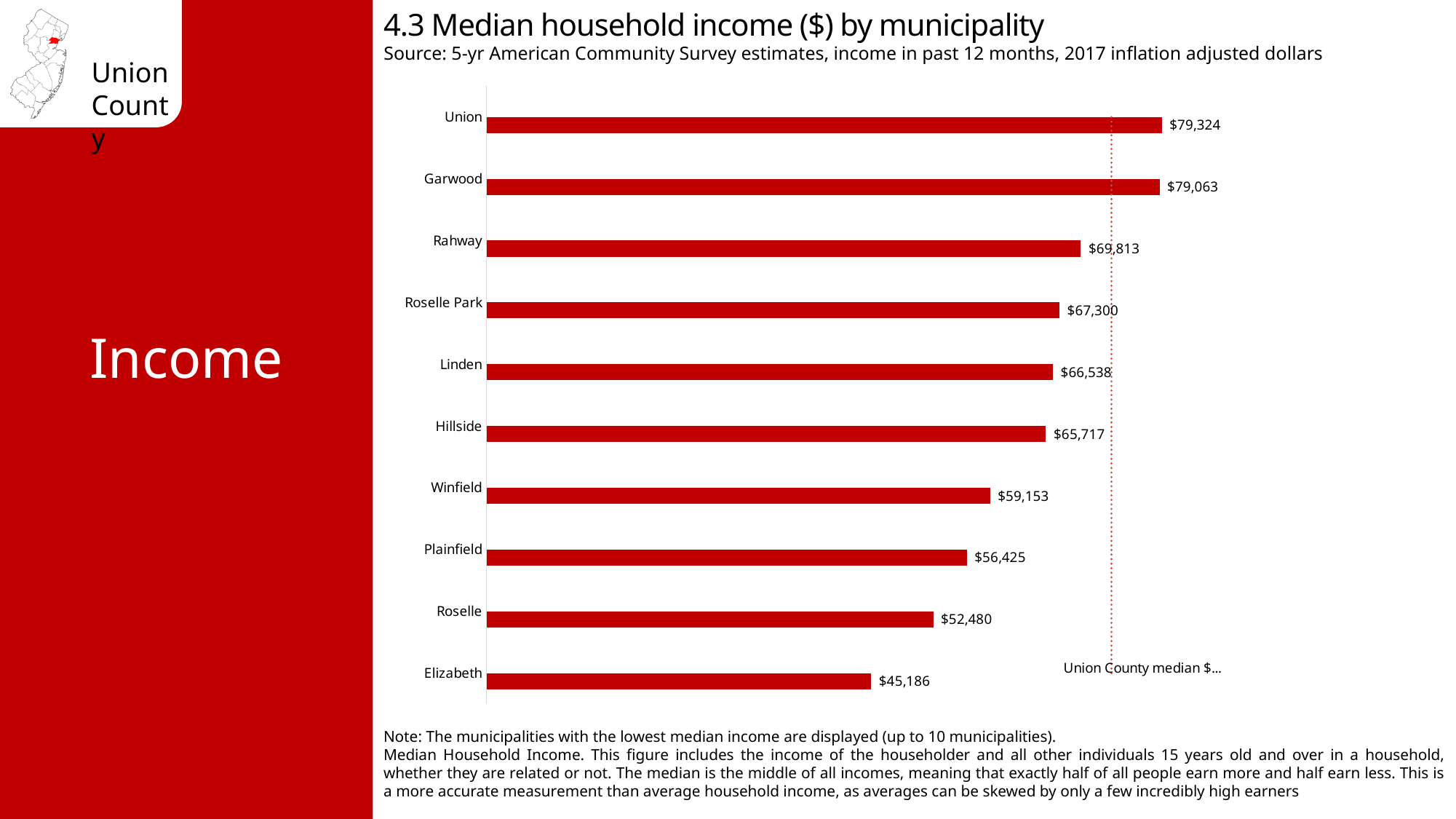
Which municipality has the lowest median household income on the chart? Elizabeth What is the title of the chart? 4.3 Median household income ($) by municipality What type of chart is used to show median household income by municipality? Bar chart Which municipality has the highest median household income on the chart? Union Which has a higher median household income, Linden or Roselle? Linden What is the median household income shown for Rahway? $69,813 What is the difference between the median household income of Union and that of Elizabeth? $34,138 What is the median household income shown for Roselle Park? $67,300 How many municipalities are shown on the chart? 10 What is the difference between the median household income of Winfield and that of Plainfield? $2,728 What is the median household income shown for Elizabeth? $45,186 What is the median household income shown for Winfield? $59,153